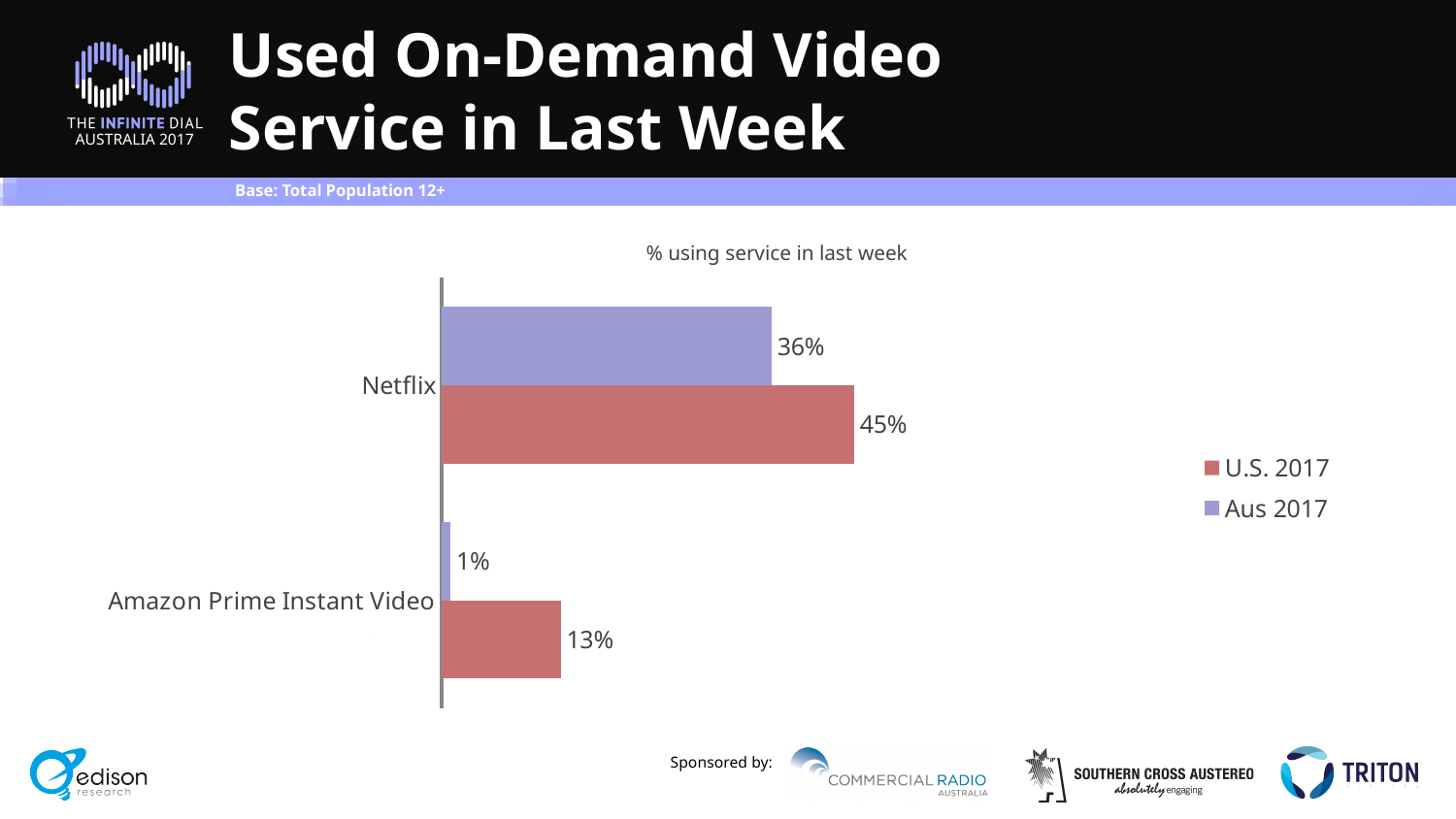
Which service has the highest value for U.S. 2017? Netflix What is the difference between the U.S. 2017 and Aus 2017 values for Amazon Prime Instant Video? 12% What is the Aus 2017 value for Amazon Prime Instant Video? 1% What type of chart is shown on the slide? Bar chart What is the U.S. 2017 value for Amazon Prime Instant Video? 13% What percentage of the Aus 2017 population used Netflix in the last week? 36% Which is larger for Amazon Prime Instant Video: the U.S. 2017 value or the Aus 2017 value? U.S. 2017 What percentage of the U.S. 2017 population used Netflix in the last week? 45% How many services are shown on the chart? 2 What is the difference between the U.S. 2017 and Aus 2017 values for Netflix? 9% How many series does the legend list? 2 Which service has the lowest value for Aus 2017? Amazon Prime Instant Video